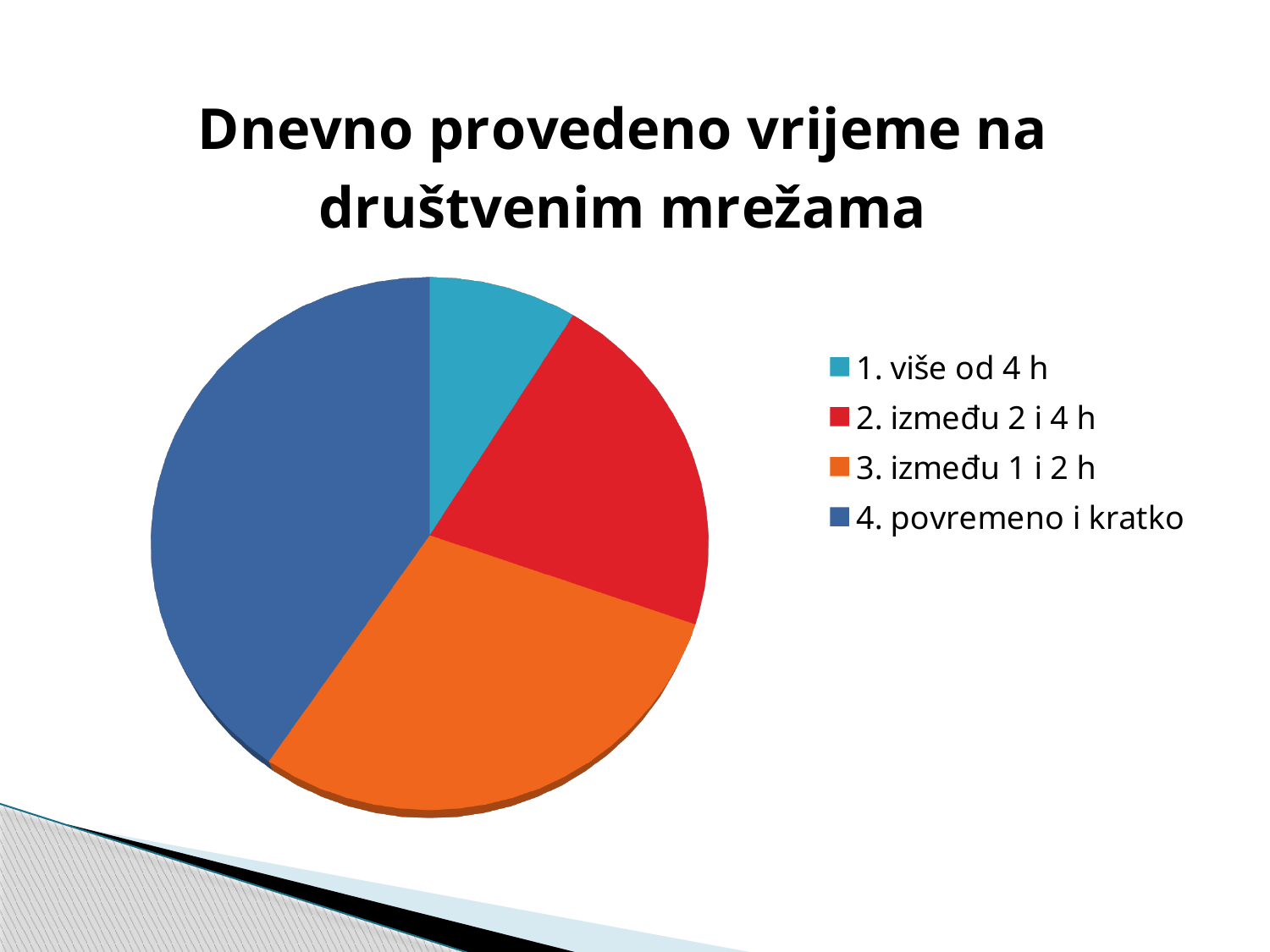
What is the title of the chart? Dnevno provedeno vrijeme na društvenim mrežama Which slice is larger: "4. povremeno i kratko" or "3. između 1 i 2 h"? 4. povremeno i kratko What kind of chart is shown on the slide? Pie chart Which category has the largest slice of the pie? 4. povremeno i kratko How many entries are listed in the legend? 4 How many categories (slices) does the pie chart have? 4 What colour is the slice for "3. između 1 i 2 h"? Orange Which category has the smallest slice of the pie? 1. više od 4 h Which slice is larger: "3. između 1 i 2 h" or "2. između 2 i 4 h"? 3. između 1 i 2 h Which slice is larger: "2. između 2 i 4 h" or "1. više od 4 h"? 2. između 2 i 4 h